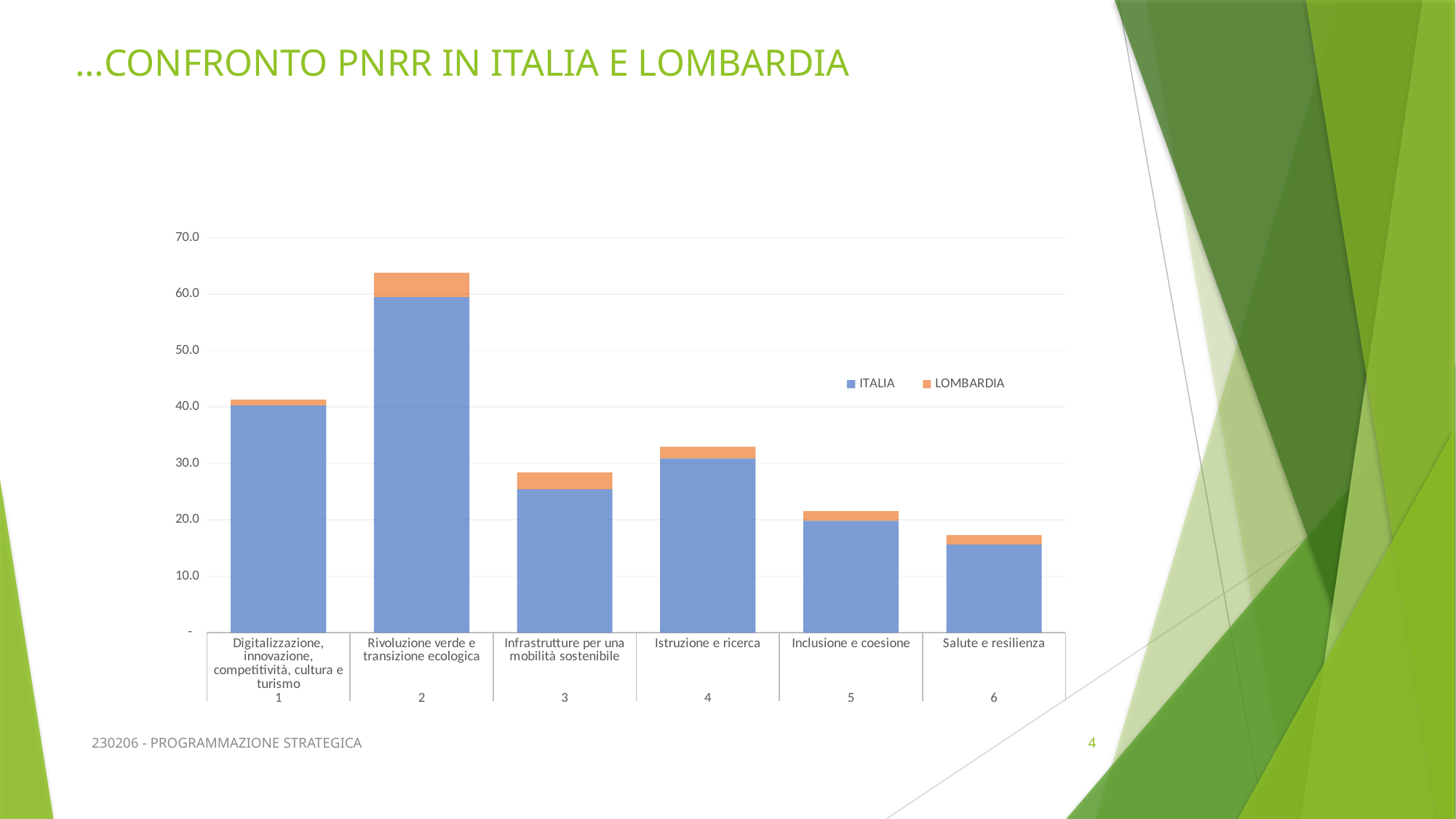
How many series does the chart legend list? 2 What are the two series named in the chart legend? ITALIA and LOMBARDIA Which category has the tallest stacked bar? Rivoluzione verde e transizione ecologica Is the ITALIA value for Digitalizzazione, innovazione, competitività, cultura e turismo greater or less than 30.0? greater Is the ITALIA value for Rivoluzione verde e transizione ecologica greater or less than 50.0? greater Is the ITALIA value for Salute e resilienza greater or less than 20.0? less Which category has the shortest stacked bar? Salute e resilienza How many categories are shown on the x axis of the chart? 6 Which series is shown in blue in the chart? ITALIA Which has a larger ITALIA value: Istruzione e ricerca or Infrastrutture per una mobilità sostenibile? Istruzione e ricerca What kind of chart is shown on the slide? Stacked bar chart